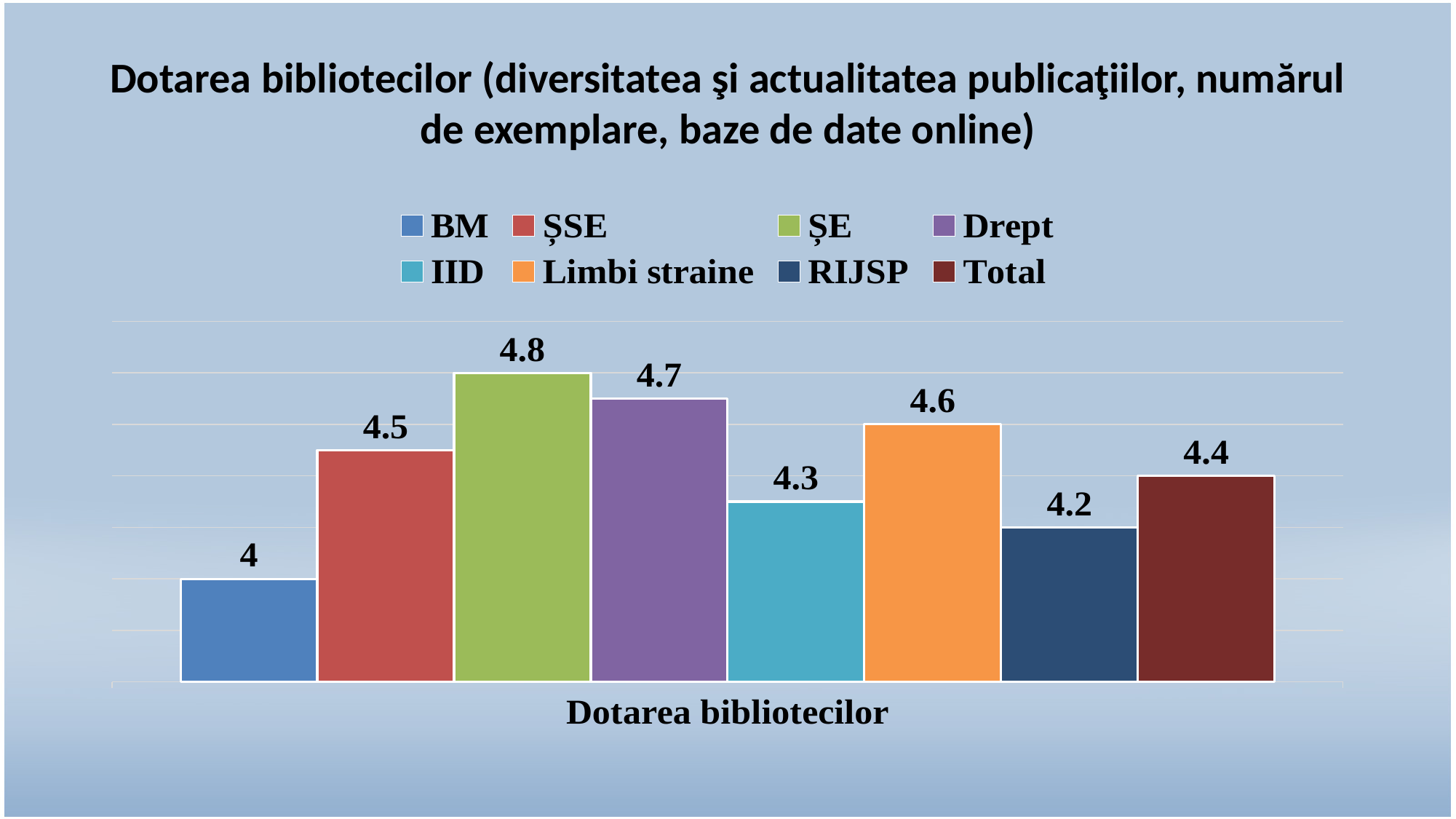
What is the value for BM? 4 What is the value for ȘE? 4.8 Which series has the lowest value? BM What is the value for Limbi straine? 4.6 Which series has the highest value? ȘE What is the value for Total? 4.4 What is the difference between the values for ȘE and BM? 0.8 What is the difference between the values for Drept and RIJSP? 0.5 How many series does the legend list? 8 What kind of chart is shown on the slide? Bar chart What is the label shown on the x axis below the bars? Dotarea bibliotecilor Which is larger, the value for ȘSE or the value for IID? ȘSE